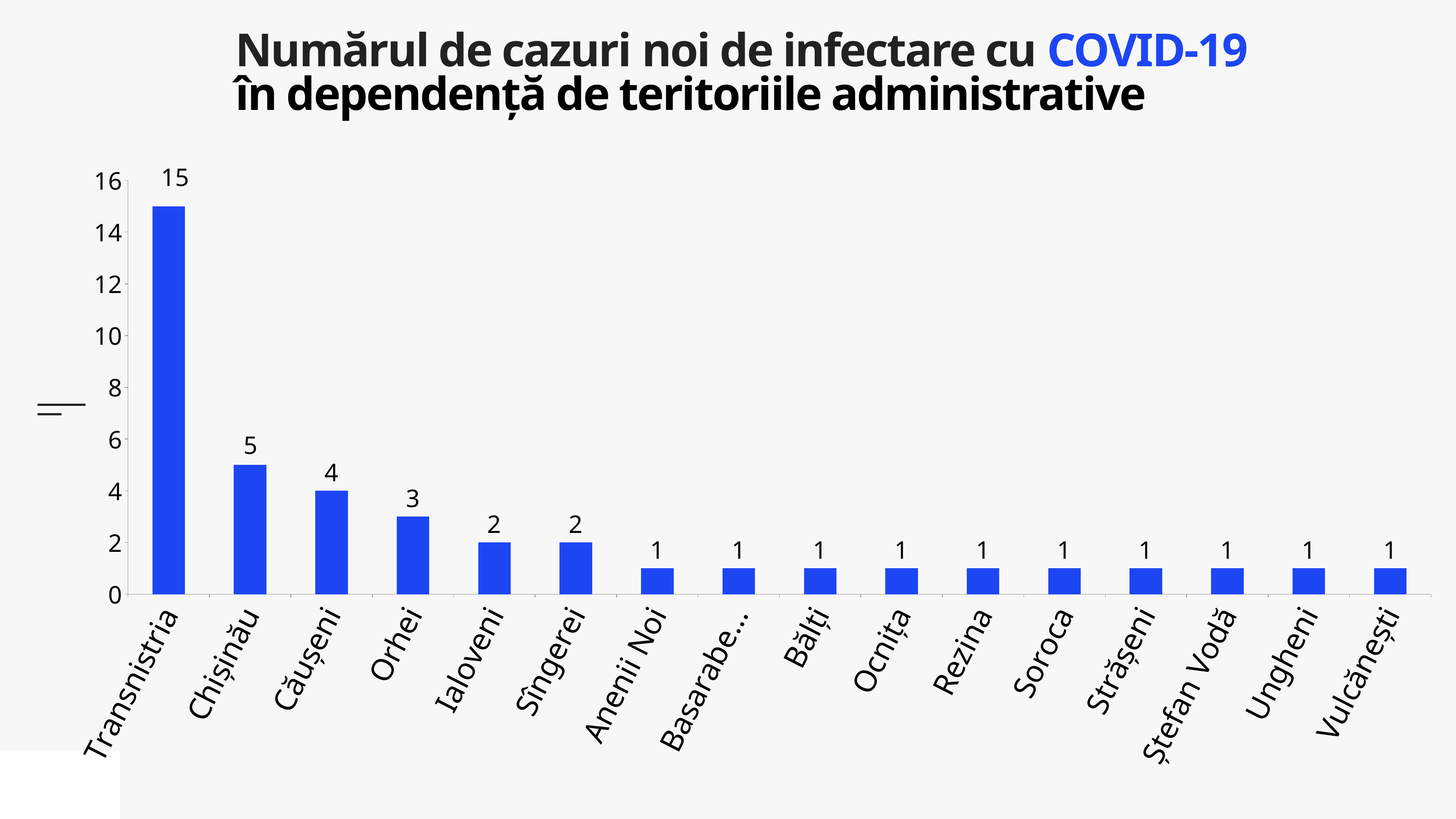
Do the values rise or fall from left to right along the x axis? fall How many categories are shown on the x axis? 16 Is the value for Transnistria greater or less than 10? greater What is the difference between the values for Căușeni and Ialoveni? 2 What is the value for Sîngerei? 2 What kind of chart is shown on the slide? bar chart What is the value for Transnistria? 15 Which is larger, the value for Căușeni or the value for Orhei? Căușeni What is the value for Chișinău? 5 What is the value for Orhei? 3 What is the difference between the values for Transnistria and Chișinău? 10 Which category has the highest value? Transnistria